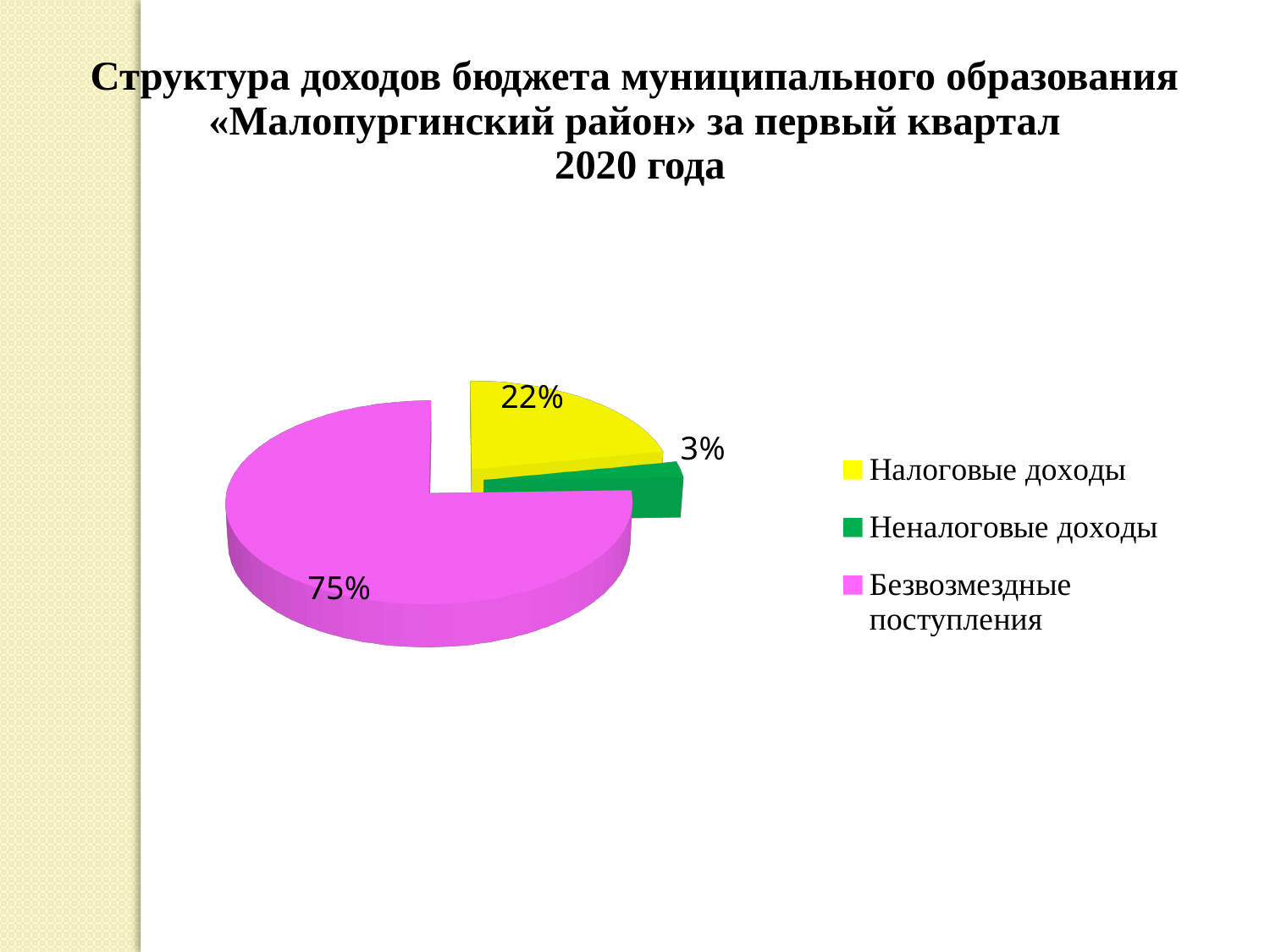
Which is larger: Налоговые доходы or Неналоговые доходы? Налоговые доходы What share of the pie does Неналоговые доходы represent? 3% What is the difference in percentage points between Безвозмездные поступления and Налоговые доходы? 53 What kind of chart is shown on the slide? pie chart What is the difference in percentage points between Налоговые доходы and Неналоговые доходы? 19 Which category has the smallest slice of the pie? Неналоговые доходы What share of the pie does Безвозмездные поступления represent? 75% How many slices does the pie chart have? 3 What colour is the slice for Безвозмездные поступления? pink Which legend entry is shown in green? Неналоговые доходы Which category has the largest slice of the pie? Безвозмездные поступления What share of the pie does Налоговые доходы represent? 22%